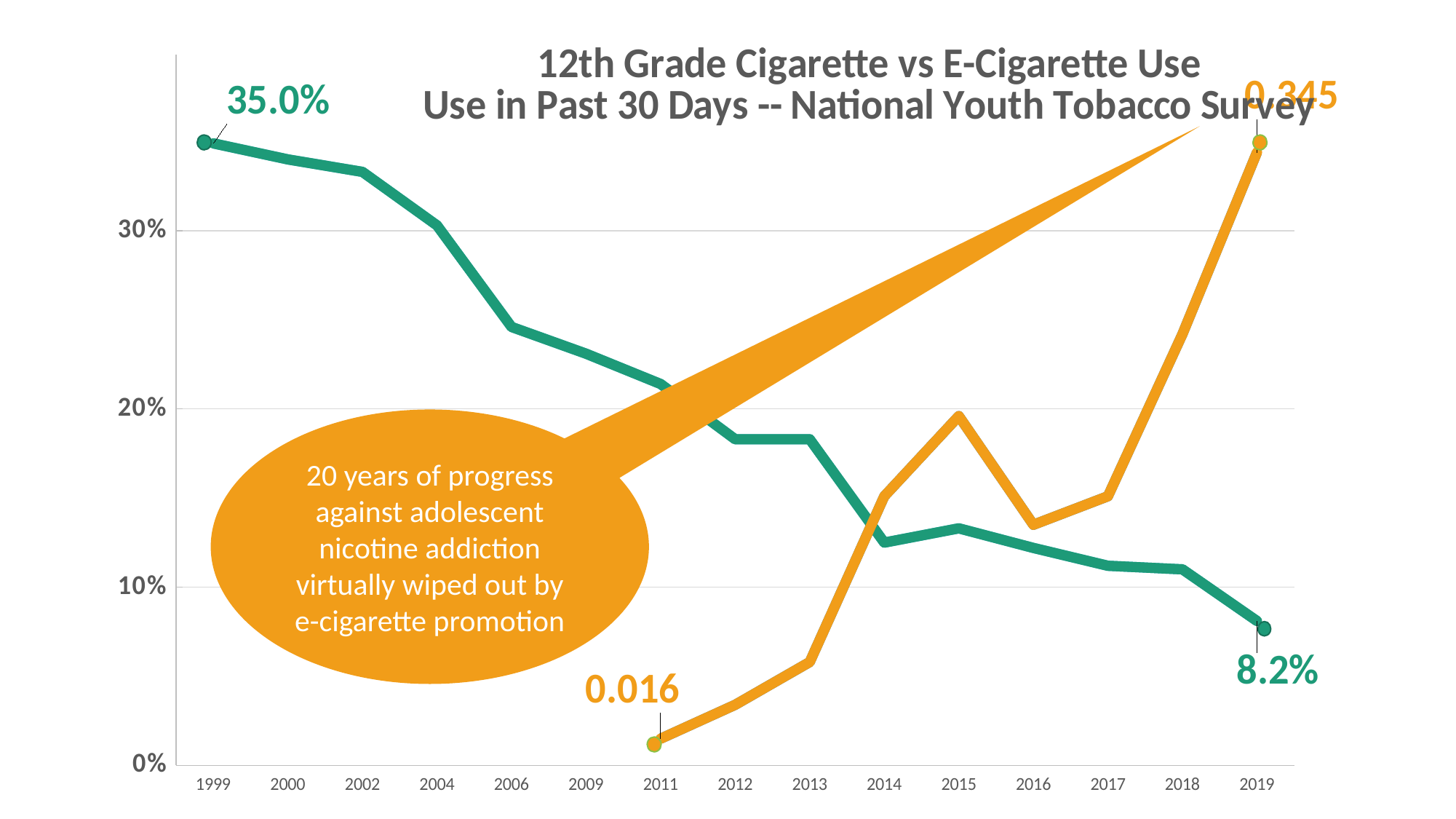
How many years are shown on the x axis? 15 What kind of chart is shown on the slide? line chart What value is labelled on the green line for 2019? 8.2% By how much did the green line's labelled value drop from 1999 to 2019? 26.8% Is the value of the green line in 2006 greater or less than 20%? greater Is the value of the orange line in 2016 greater or less than 20%? less What value is labelled on the orange line for 2011? 0.016 Does the green line rise or fall from 1999 to 2019? fall What is the title of the chart? 12th Grade Cigarette vs E-Cigarette Use Use in Past 30 Days -- National Youth Tobacco Survey What value is labelled on the green line for 1999? 35.0% What value is labelled on the orange line for 2019? 0.345 In 2019, which line has the higher value, the green line or the orange line? the orange line